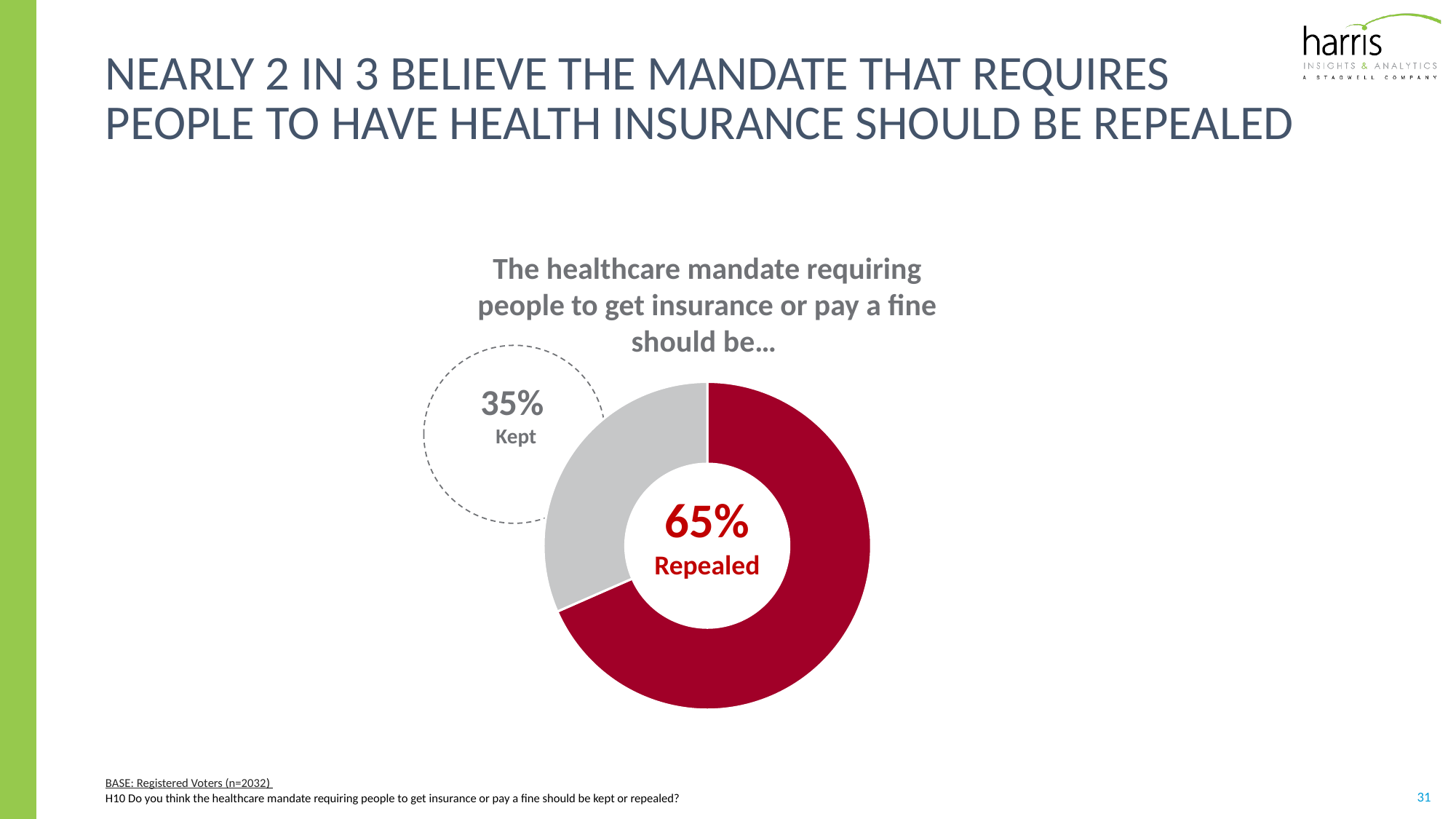
How many categories are shown in the chart? 2 Which response has the larger share of the chart, Kept or Repealed? Repealed Is the share for Repealed larger or smaller than the share for Kept? larger Which response has the smaller share of the chart? Kept What share of the chart does the Repealed slice represent? 65% What is the difference in percentage points between Repealed and Kept? 30 What kind of chart is shown on the slide? Doughnut (pie) chart What percentage of respondents say the healthcare mandate should be kept? 35% What colour is the Repealed segment of the chart? Red Do the two percentages shown in the chart add up to 100%? Yes What is the title of the chart? The healthcare mandate requiring people to get insurance or pay a fine should be… What percentage of respondents say the healthcare mandate should be repealed? 65%